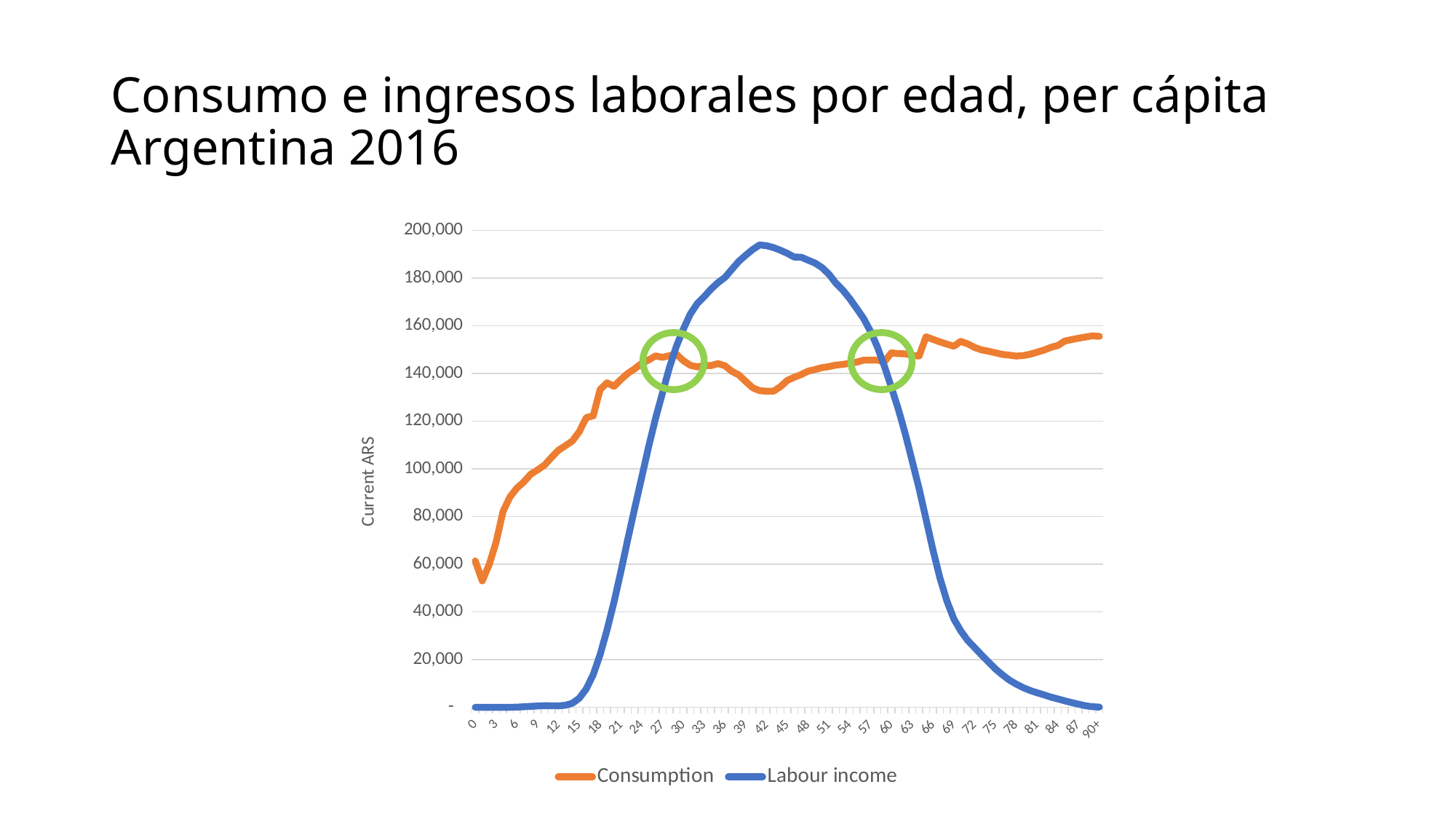
At age 42, which series has the larger value, Consumption or Labour income? Labour income What are the two series named in the legend? Consumption and Labour income Does Consumption rise or fall between age 0 and age 21? rise At age 75, which series has the larger value, Consumption or Labour income? Consumption Is the value of Consumption at age 0 greater or less than 80,000? less How many series does the legend list? 2 Is the value of Labour income at age 42 greater or less than 180,000? greater What kind of chart is shown on the slide? line chart Is the value of Labour income at age 9 greater or less than 20,000? less What is the label on the vertical axis? Current ARS Does Labour income rise or fall between age 42 and age 90+? fall